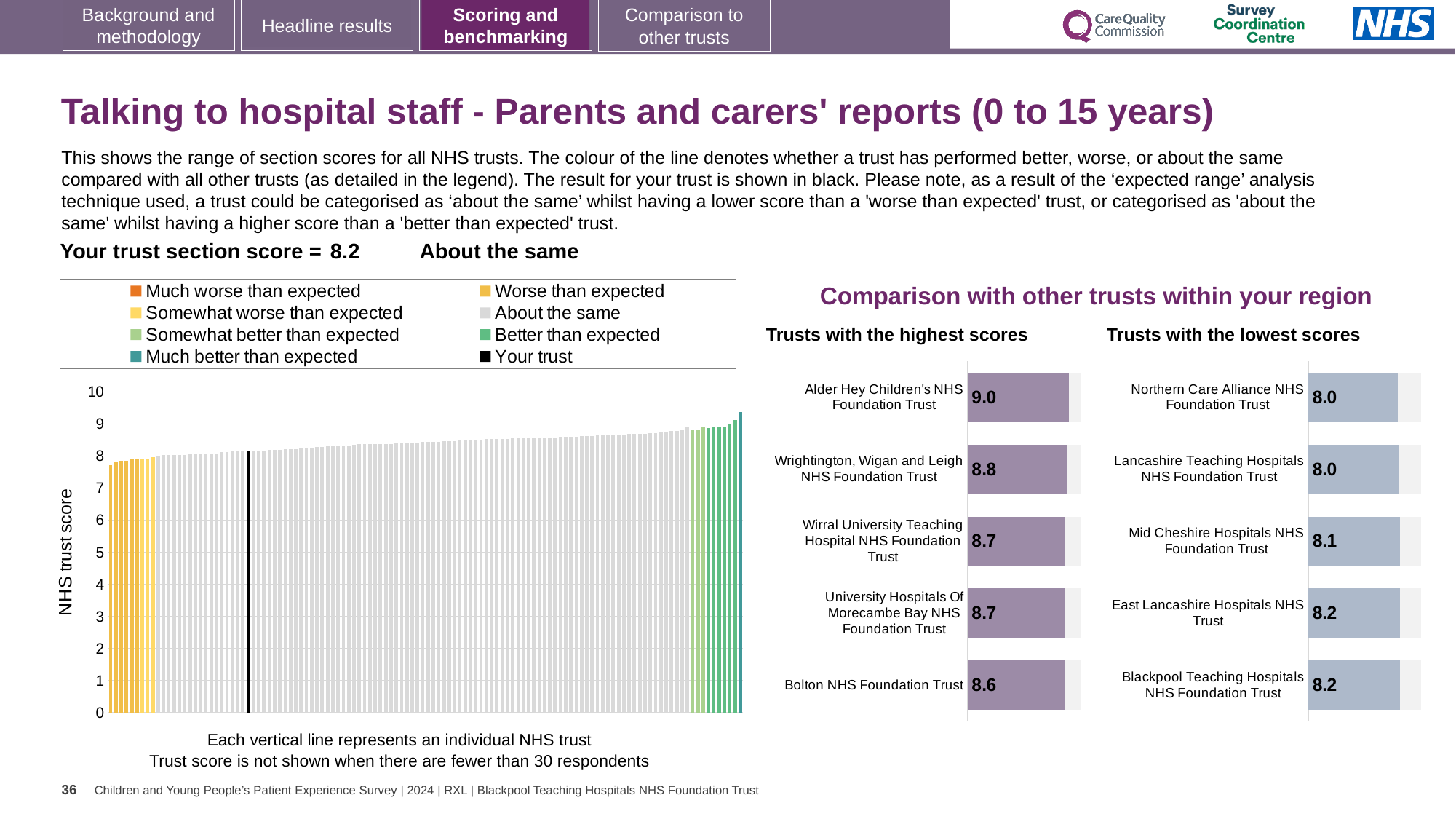
In the 'Trusts with the highest scores' chart, what is the score for Alder Hey Children's NHS Foundation Trust? 9.0 In the 'Trusts with the lowest scores' chart, what is the score for Mid Cheshire Hospitals NHS Foundation Trust? 8.1 In the 'Trusts with the lowest scores' chart, which has the larger score: Mid Cheshire Hospitals NHS Foundation Trust or Northern Care Alliance NHS Foundation Trust? Mid Cheshire Hospitals NHS Foundation Trust What is the y-axis title of the main chart on the left? NHS trust score What kind of chart is the main chart on the left showing all NHS trusts? Bar chart In the main chart on the left, do the trust scores rise or fall from left to right? Rise In the main chart on the left, is the value of the black bar (your trust) greater or less than 5? greater How many entries does the legend of the main chart on the left list? 8 In the 'Trusts with the highest scores' chart, what is the difference between the scores of Alder Hey Children's NHS Foundation Trust and Bolton NHS Foundation Trust? 0.4 In the 'Trusts with the highest scores' chart, which trust has the highest score? Alder Hey Children's NHS Foundation Trust How many trusts are shown in the 'Trusts with the lowest scores' chart? 5 In the 'Trusts with the highest scores' chart, what is the score for Bolton NHS Foundation Trust? 8.6